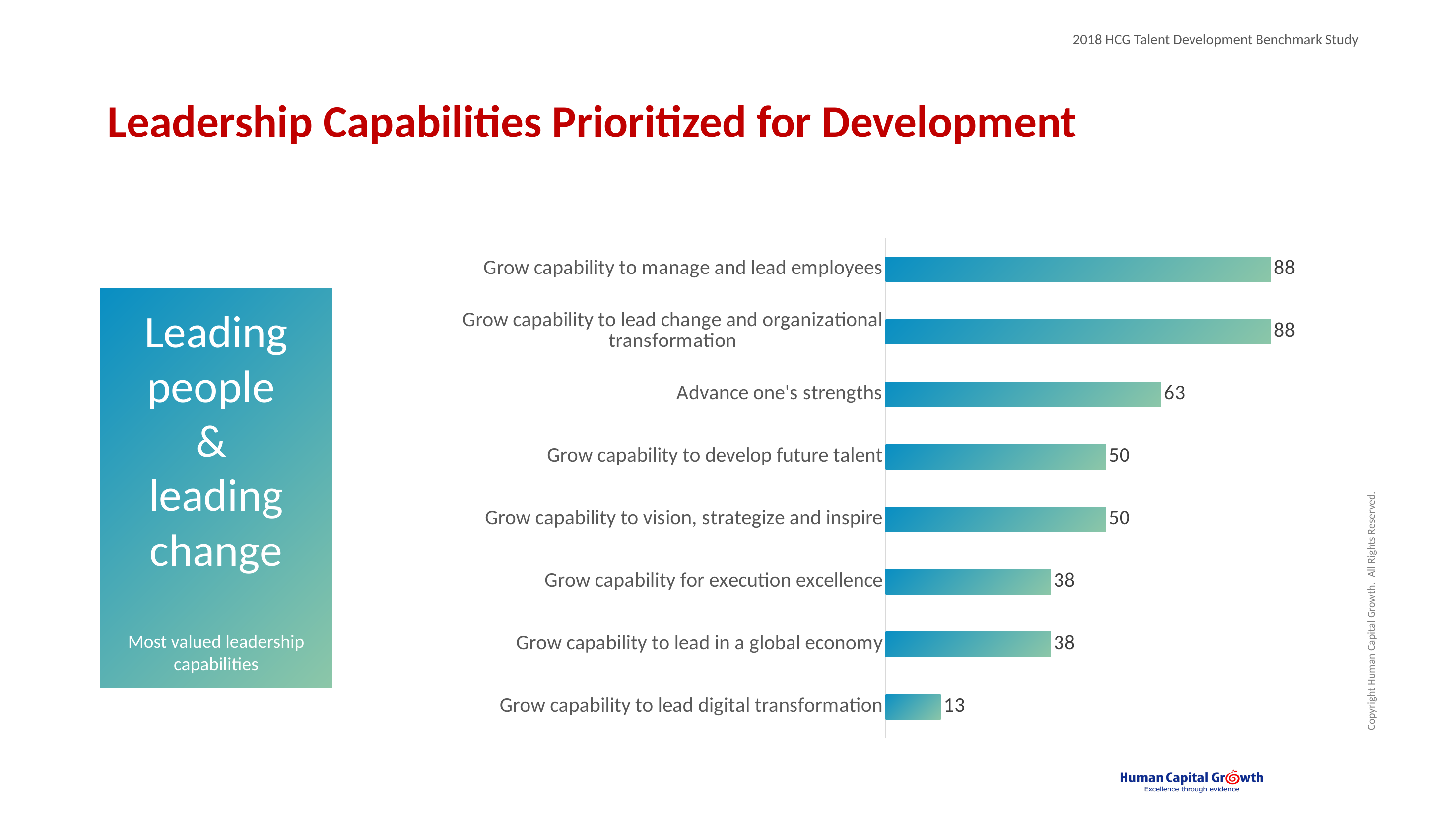
What is the difference between the values for "Grow capability to manage and lead employees" and "Advance one's strengths"? 25 What is the title of the slide containing the chart? Leadership Capabilities Prioritized for Development What is the highest value shown in the chart? 88 What is the difference between the values for "Grow capability to develop future talent" and "Grow capability to lead digital transformation"? 37 Which category has the lowest value? Grow capability to lead digital transformation What is the value for "Grow capability to lead digital transformation"? 13 What is the value for "Grow capability for execution excellence"? 38 How many categories are shown in the chart? 8 What is the value for "Grow capability to develop future talent"? 50 What kind of chart is shown on the slide? Bar chart What is the value for "Advance one's strengths"? 63 Which is larger: the value for "Advance one's strengths" or the value for "Grow capability to lead in a global economy"? Advance one's strengths